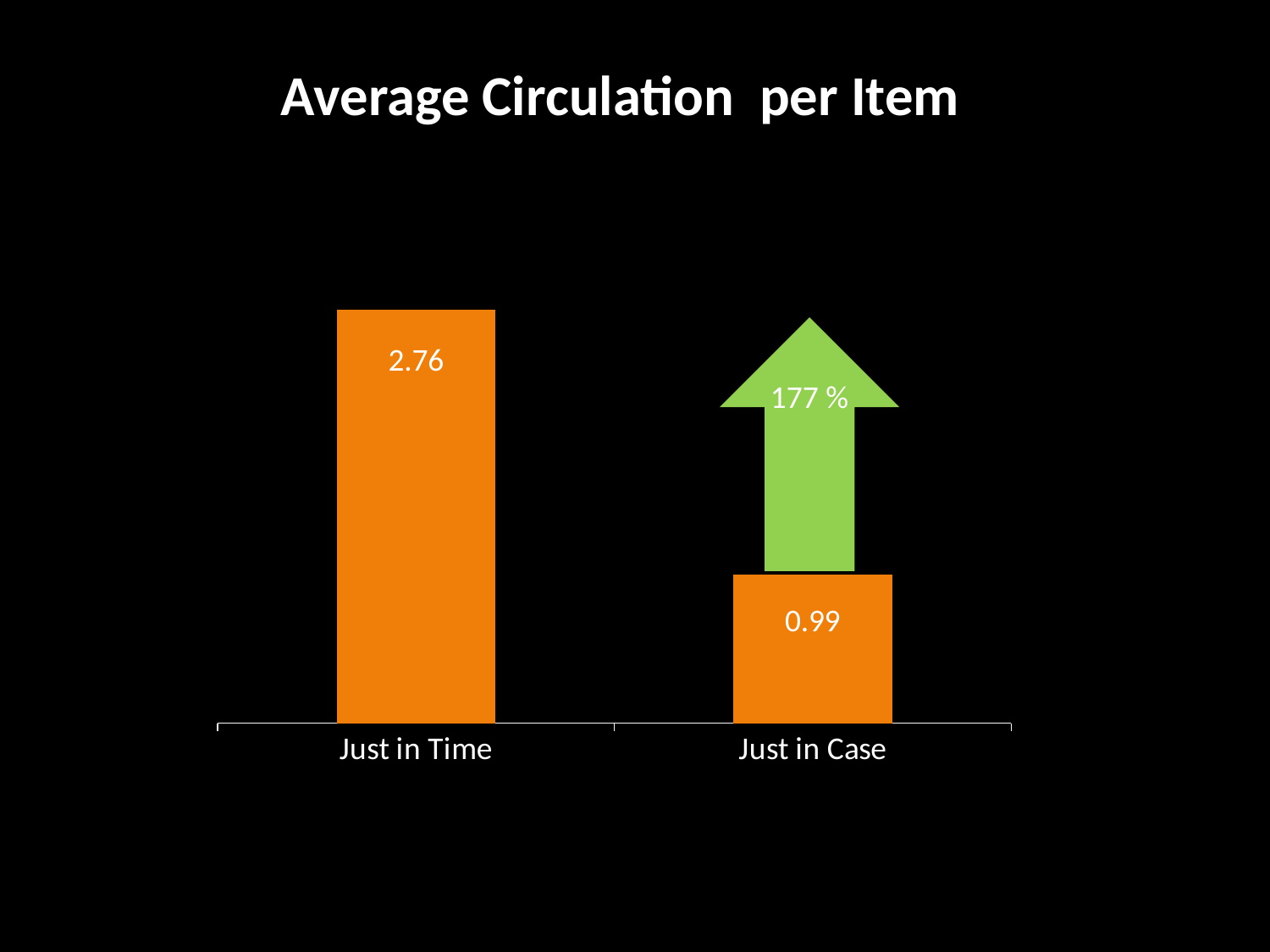
What is the average circulation per item for Just in Time? 2.76 What percentage is printed on the green arrow above the Just in Case bar? 177 % What is the average circulation per item for Just in Case? 0.99 Which is larger, the value for Just in Time or the value for Just in Case? Just in Time Which category has the highest average circulation per item? Just in Time Which category has the lowest average circulation per item? Just in Case How many categories are shown on the x axis? 2 What is the title of the chart? Average Circulation per Item What kind of chart is shown on the slide? Bar chart What is the difference between the Just in Time and Just in Case values? 1.77